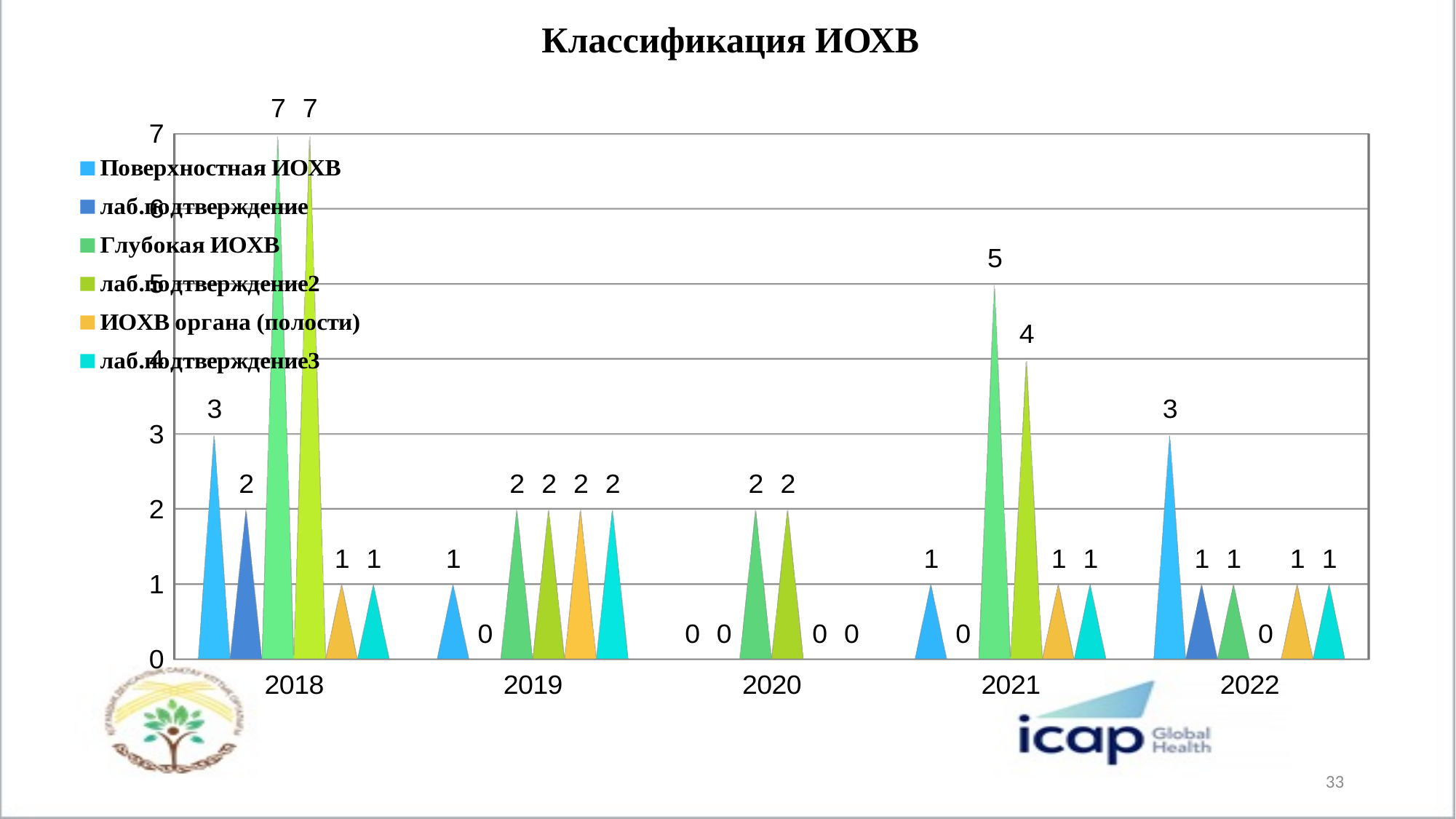
What is the value for лаб.подтверждение in 2022? 1 What is the value for Поверхностная ИОХВ in 2018? 3 What is the value for Глубокая ИОХВ in 2021? 5 Which year has the larger value for Поверхностная ИОХВ, 2018 or 2021? 2018 In which year is the value for Поверхностная ИОХВ the lowest? 2020 How many years are shown on the x axis? 5 What is the value for лаб.подтверждение2 in 2018? 7 What kind of chart is shown on the slide? Bar chart How many series does the legend list? 6 What is the value for ИОХВ органа (полости) in 2019? 2 In which year is the value for Глубокая ИОХВ the highest? 2018 What is the difference between the Глубокая ИОХВ values in 2018 and 2021? 2